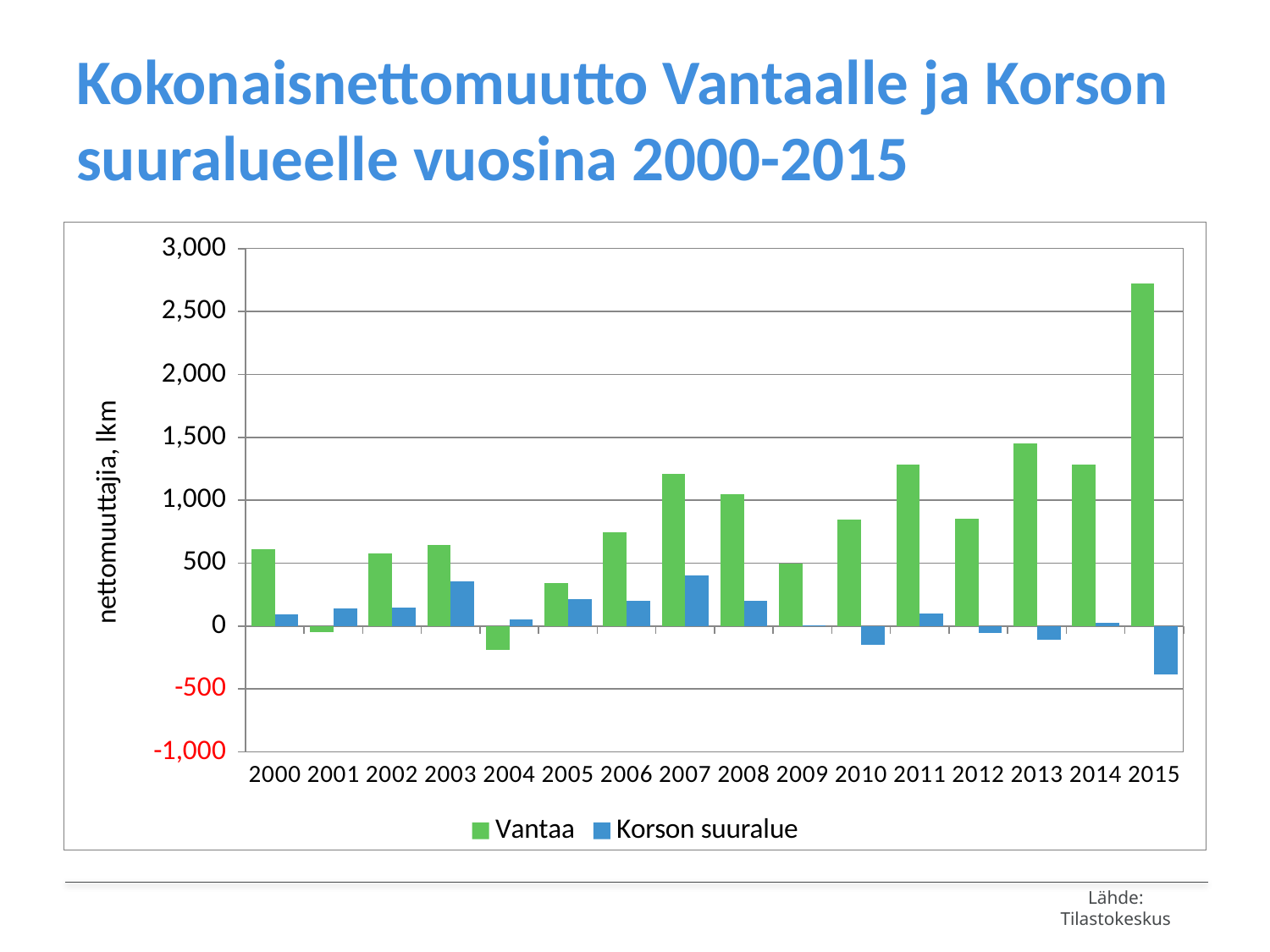
What is the label on the vertical axis? nettomuuttajia, lkm Is the Vantaa value for 2015 greater or less than 2,500? greater Is the Vantaa value for 2007 greater or less than 1,000? greater How many years are shown on the x axis? 16 What kind of chart is shown on the slide? bar chart Which year has the larger Vantaa value, 2013 or 2011? 2013 In which year is the Vantaa value lowest? 2004 Is the Korson suuralue value for 2015 greater or less than -500? greater In which year is the Vantaa value highest? 2015 How many series does the legend list? 2 In which year is the Korson suuralue value lowest? 2015 In which year is the Korson suuralue value highest? 2007